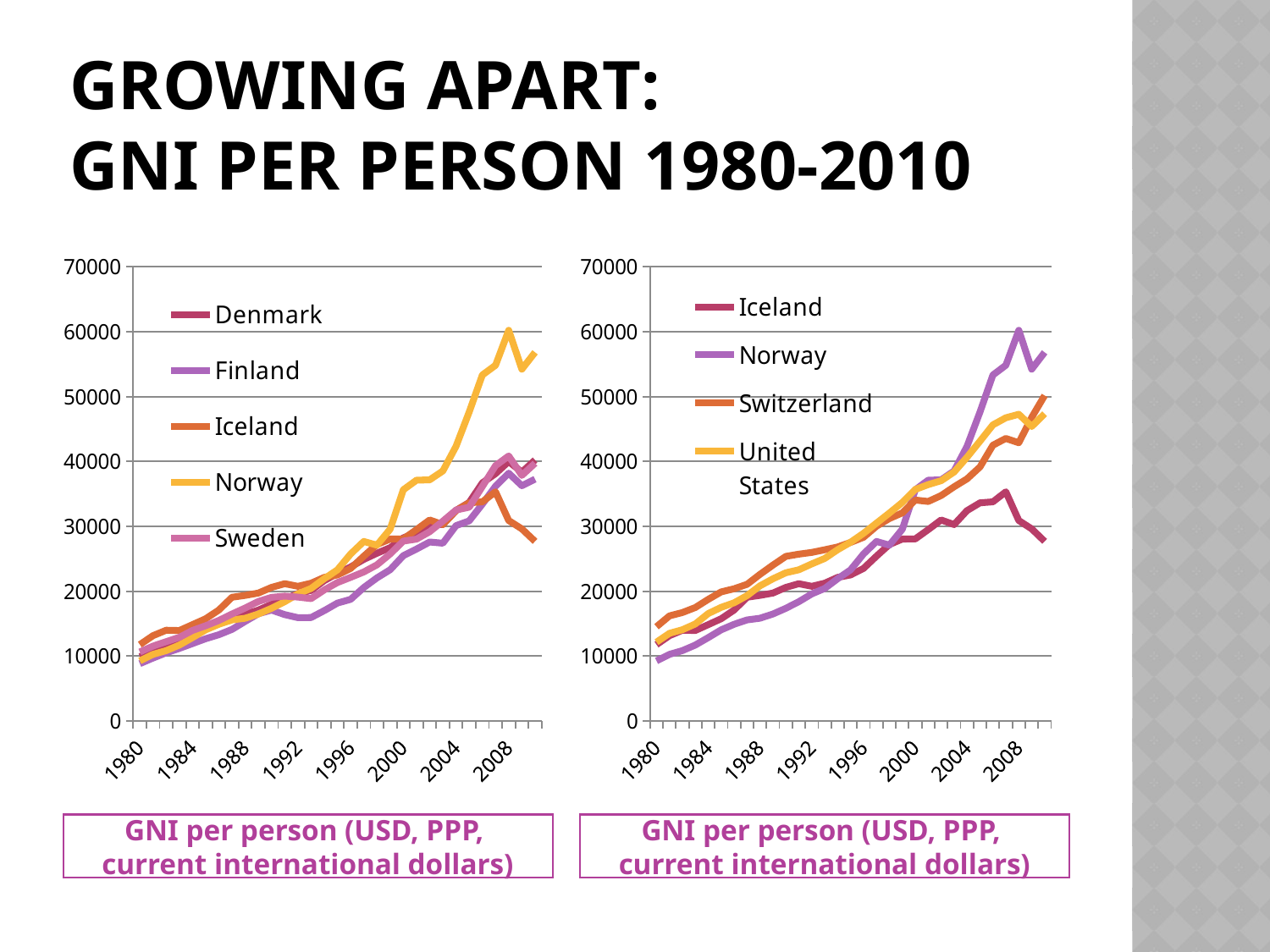
How many series does the legend of the right chart list? 4 In the left chart, which series reaches the highest value around 2008? Norway In the right chart, does the value for Iceland rise or fall between 2008 and 2010? fall In the right chart, is the value for Iceland in 2010 greater or less than 30000? less What kind of chart is the left chart on the slide? line chart How many series does the legend of the left chart list? 5 What caption appears below each chart? GNI per person (USD, PPP, current international dollars) In the right chart, which is larger in 2010, the value for Switzerland or the value for Iceland? Switzerland In the left chart, is the peak value for Norway around 2008 greater or less than 50000? greater In the right chart, which series has the lowest value at the end of the period (2010)? Iceland In the left chart, does the value for Finland generally rise or fall from 1980 to 2010? rise